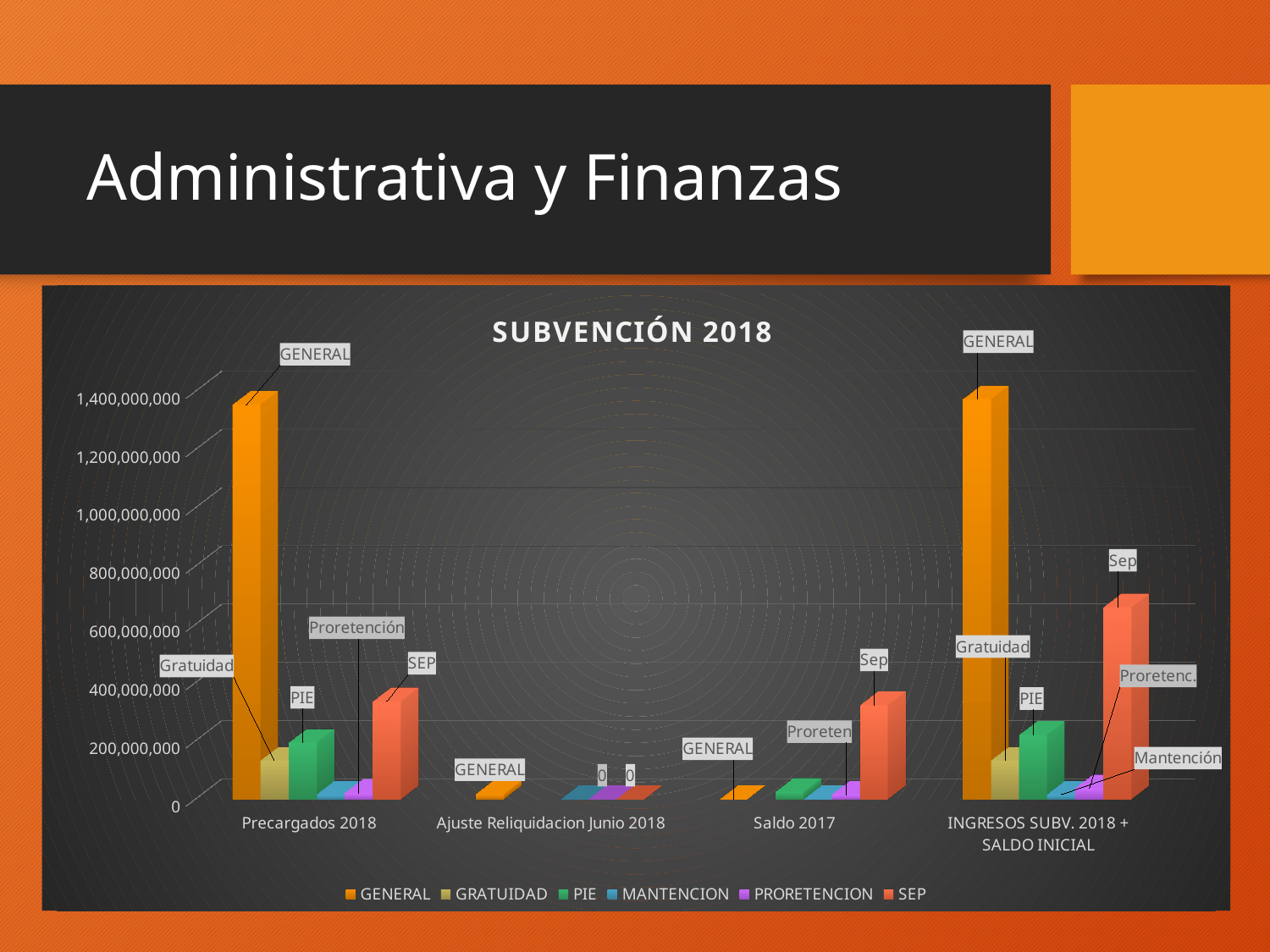
Which category has the tallest bar in the chart? INGRESOS SUBV. 2018 + SALDO INICIAL How many series does the chart legend list? 6 What kind of chart is shown on the slide? bar chart For Precargados 2018, which is larger: GENERAL or SEP? GENERAL Is the SEP value for INGRESOS SUBV. 2018 + SALDO INICIAL greater or less than 600,000,000? greater Is the GENERAL value for Precargados 2018 greater or less than 1,200,000,000? greater Is the SEP value for Saldo 2017 greater or less than 200,000,000? greater Which series is shown in orange in the chart legend? GENERAL How many categories are shown along the x axis of the chart? 4 Which category has the larger SEP value: Saldo 2017 or INGRESOS SUBV. 2018 + SALDO INICIAL? INGRESOS SUBV. 2018 + SALDO INICIAL What is the title of the chart? SUBVENCIÓN 2018 Which category has the lowest values overall in the chart? Ajuste Reliquidacion Junio 2018